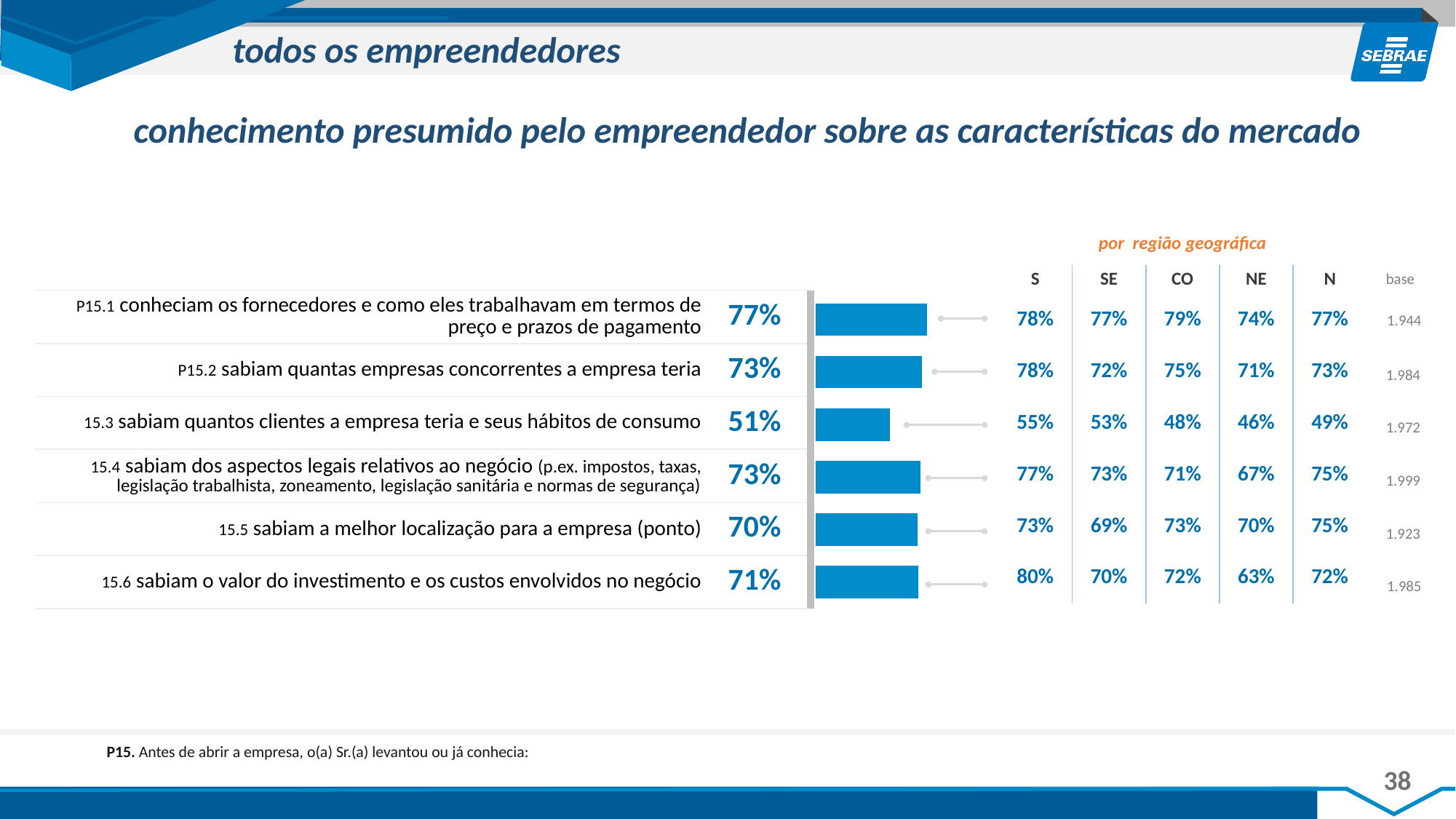
Which is larger: the value for 15.5 (sabiam a melhor localização) or the value for 15.6 (sabiam o valor do investimento)? 15.6 sabiam o valor do investimento e os custos envolvidos no negócio What is the title of the chart on the slide? conhecimento presumido pelo empreendedor sobre as características do mercado What is the value for 'P15.1 conheciam os fornecedores e como eles trabalhavam em termos de preço e prazos de pagamento'? 77% Which item has the lowest value in the bar chart? 15.3 sabiam quantos clientes a empresa teria e seus hábitos de consumo What is the difference between the value for P15.1 (conheciam os fornecedores) and the value for 15.3 (sabiam quantos clientes a empresa teria)? 26% What is the value for '15.6 sabiam o valor do investimento e os custos envolvidos no negócio'? 71% Which item has the highest value in the bar chart? P15.1 conheciam os fornecedores e como eles trabalhavam em termos de preço e prazos de pagamento What is the value for '15.5 sabiam a melhor localização para a empresa (ponto)'? 70% What is the value for '15.3 sabiam quantos clientes a empresa teria e seus hábitos de consumo'? 51% What is the difference between the value for P15.2 (sabiam quantas empresas concorrentes) and the value for 15.5 (sabiam a melhor localização)? 3% How many categories (items P15.1 to 15.6) does the bar chart show? 6 What kind of chart is shown on the slide? bar chart